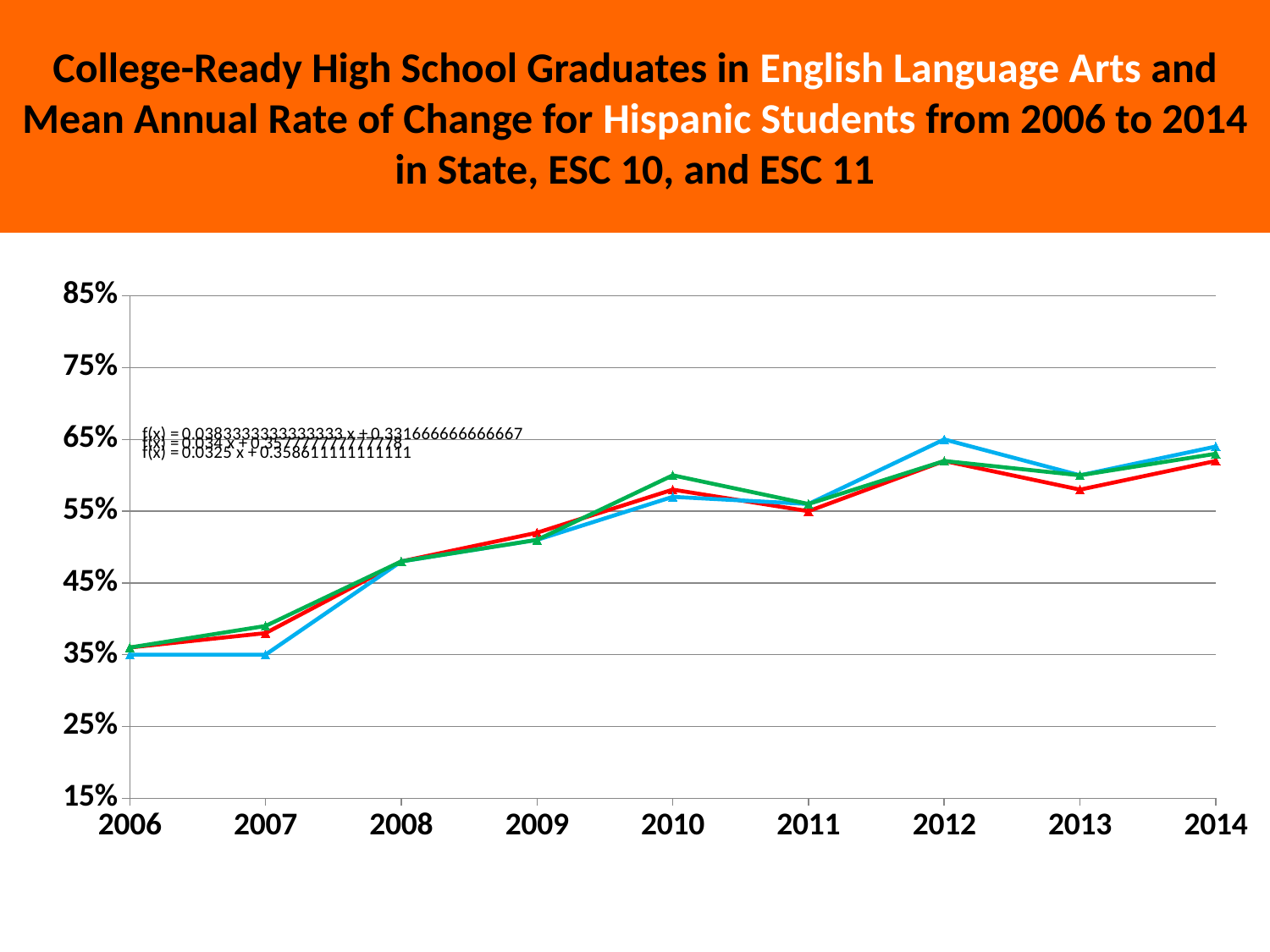
Is the value of the red line in 2014 greater or less than 55%? greater What kind of chart is shown on the slide? line chart Is the value of the blue line in 2007 greater or less than 45%? less Is the value of the blue line in 2008 greater or less than 55%? less What is the first year shown on the x axis? 2006 What is the last year shown on the x axis? 2014 Overall, do the plotted values rise or fall from 2006 to 2014? rise How many lines are plotted on the chart? 3 In which year is the red line at its lowest value? 2006 How many years are shown along the x axis of the chart? 9